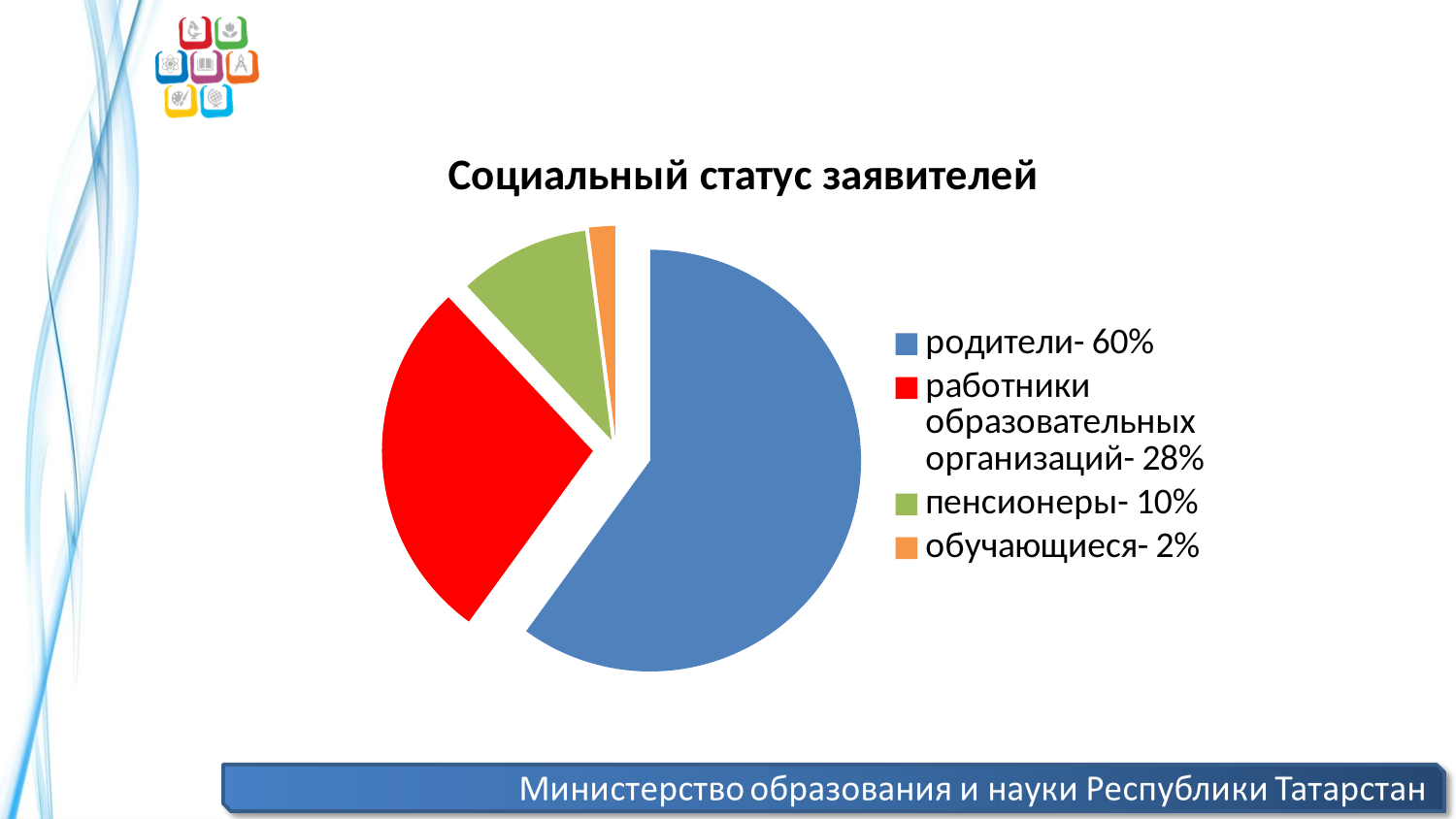
What colour is the slice for пенсионеры? green What is the title of the chart? Социальный статус заявителей Which category has the largest share of the pie? родители What share of the pie do пенсионеры account for? 10% What is the difference in percentage points between родители and работники образовательных организаций? 32 What share of the pie do работники образовательных организаций account for? 28% Which is larger, the share for пенсионеры or the share for обучающиеся? пенсионеры What share of the pie do обучающиеся account for? 2% How many categories does the pie chart show? 4 Which category has the smallest share of the pie? обучающиеся What kind of chart is shown on the slide? pie chart